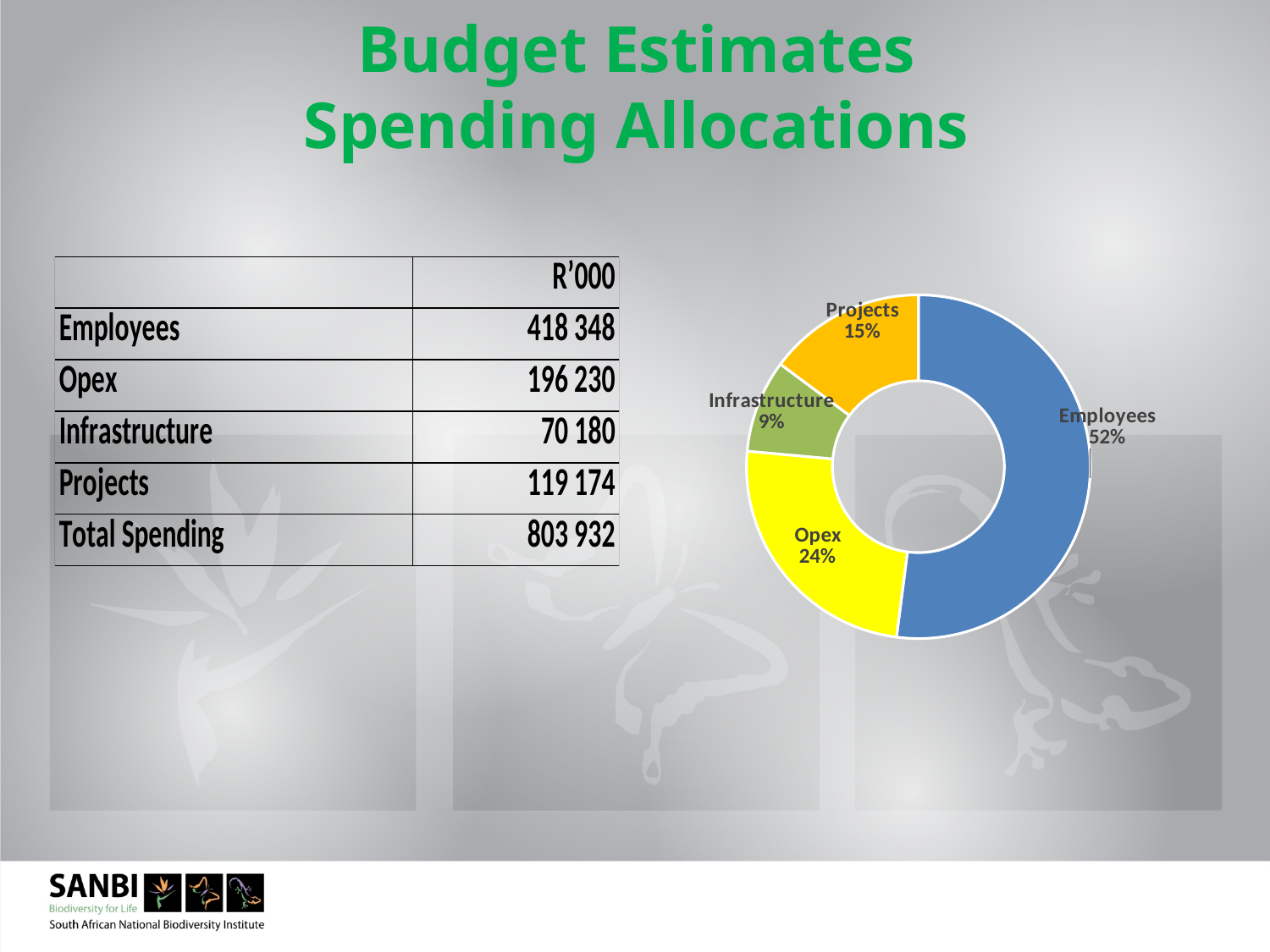
What percentage is shown for Projects in the chart? 15% What kind of chart is shown on the slide? doughnut chart How many categories are shown in the chart? 4 Which category has the smallest slice in the chart? Infrastructure What percentage is shown for Infrastructure in the chart? 9% Which category has the largest slice in the chart? Employees How many percentage points larger is the Employees share than the Opex share? 28 How many percentage points larger is the Projects share than the Infrastructure share? 6 Which slice is larger, Opex or Projects? Opex What percentage is shown for Opex in the chart? 24% What share of spending does the Employees slice represent in the chart? 52% What colour is the Employees slice in the chart? blue